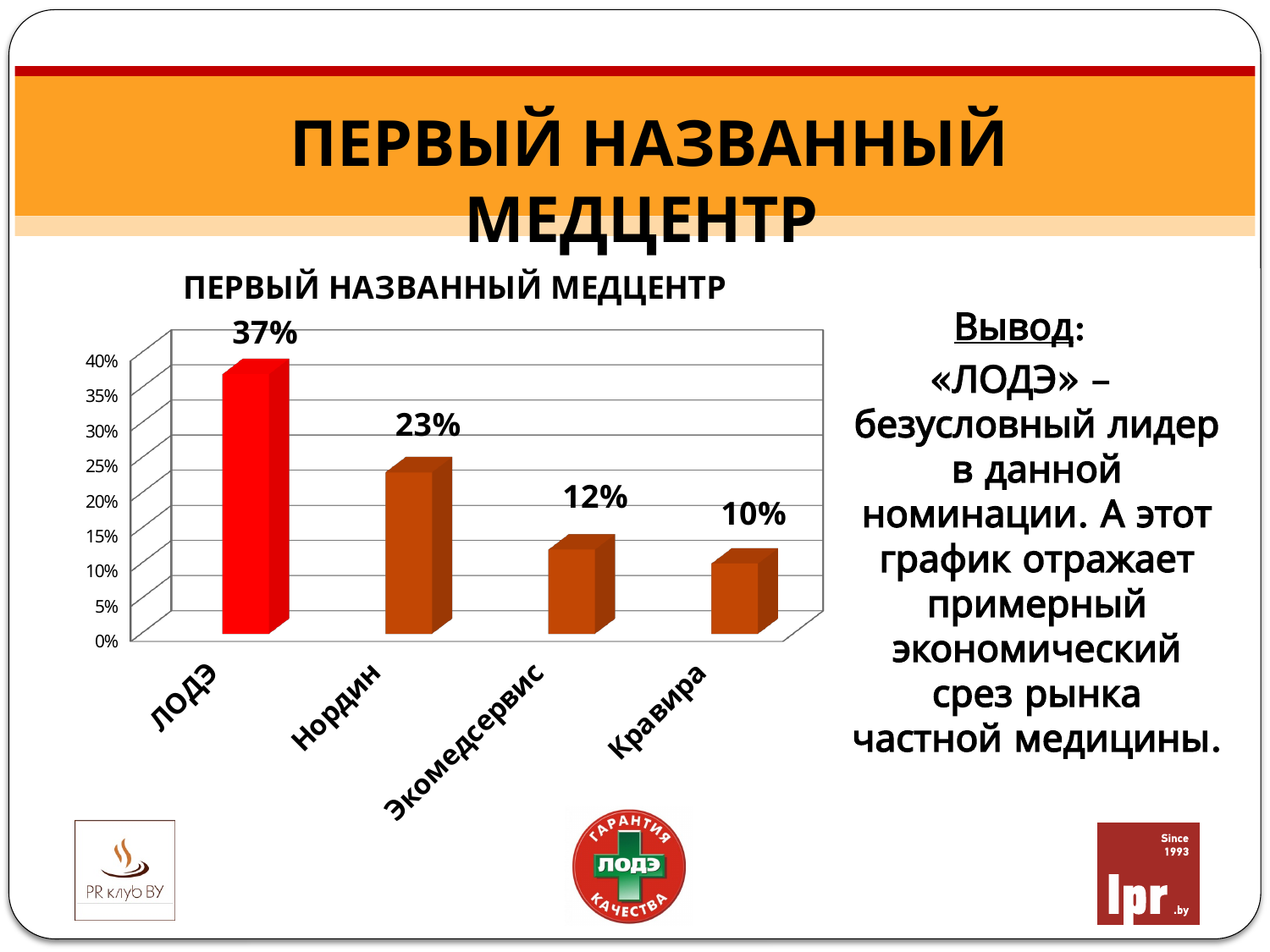
What is the title of the chart? ПЕРВЫЙ НАЗВАННЫЙ МЕДЦЕНТР What is the value for Экомедсервис? 12% What is the difference between the values for ЛОДЭ and Нордин? 14% What is the value for Кравира? 10% What is the value for ЛОДЭ? 37% What kind of chart is shown on the slide? bar chart What is the value for Нордин? 23% Which category has the lowest value? Кравира How many categories are shown in the chart? 4 Which is larger, the value for Нордин or the value for Экомедсервис? Нордин Which category has the highest value? ЛОДЭ Is the value for ЛОДЭ greater or less than 35%? greater